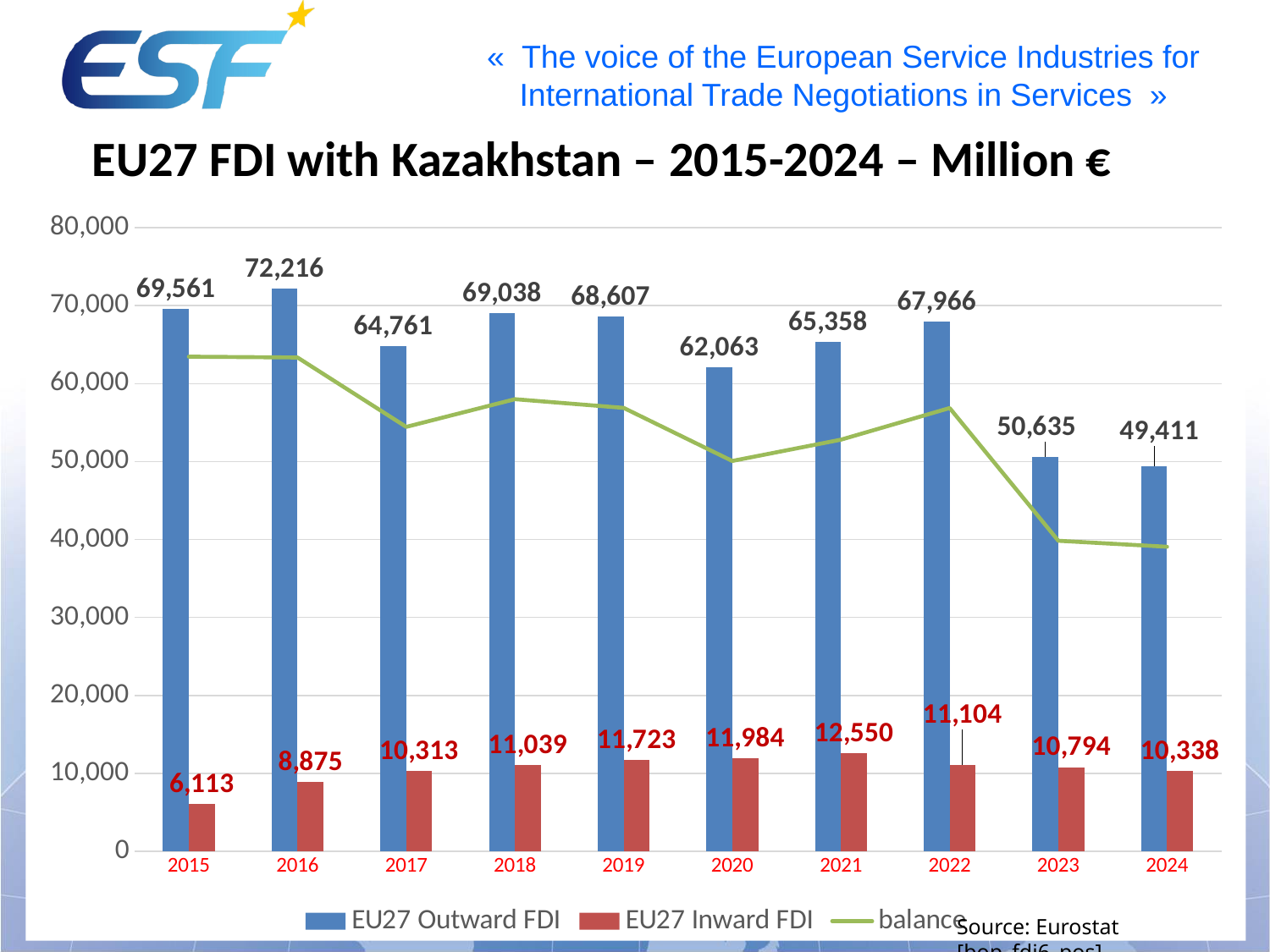
Which is larger, EU27 Outward FDI in 2022 or in 2023? 2022 What is the difference between EU27 Outward FDI and EU27 Inward FDI in 2016? 63,341 What kind of chart is this? Bar chart with a line series What is the EU27 Inward FDI value for 2021? 12,550 What is the EU27 Outward FDI value for 2016? 72,216 How many years are shown on the x axis? 10 How many series does the legend list? 3 Is the balance value for 2015 greater or less than 60,000? greater In which year is EU27 Outward FDI highest? 2016 Does EU27 Outward FDI rise or fall from 2022 to 2024? fall What is the EU27 Outward FDI value for 2024? 49,411 In which year is EU27 Inward FDI lowest? 2015